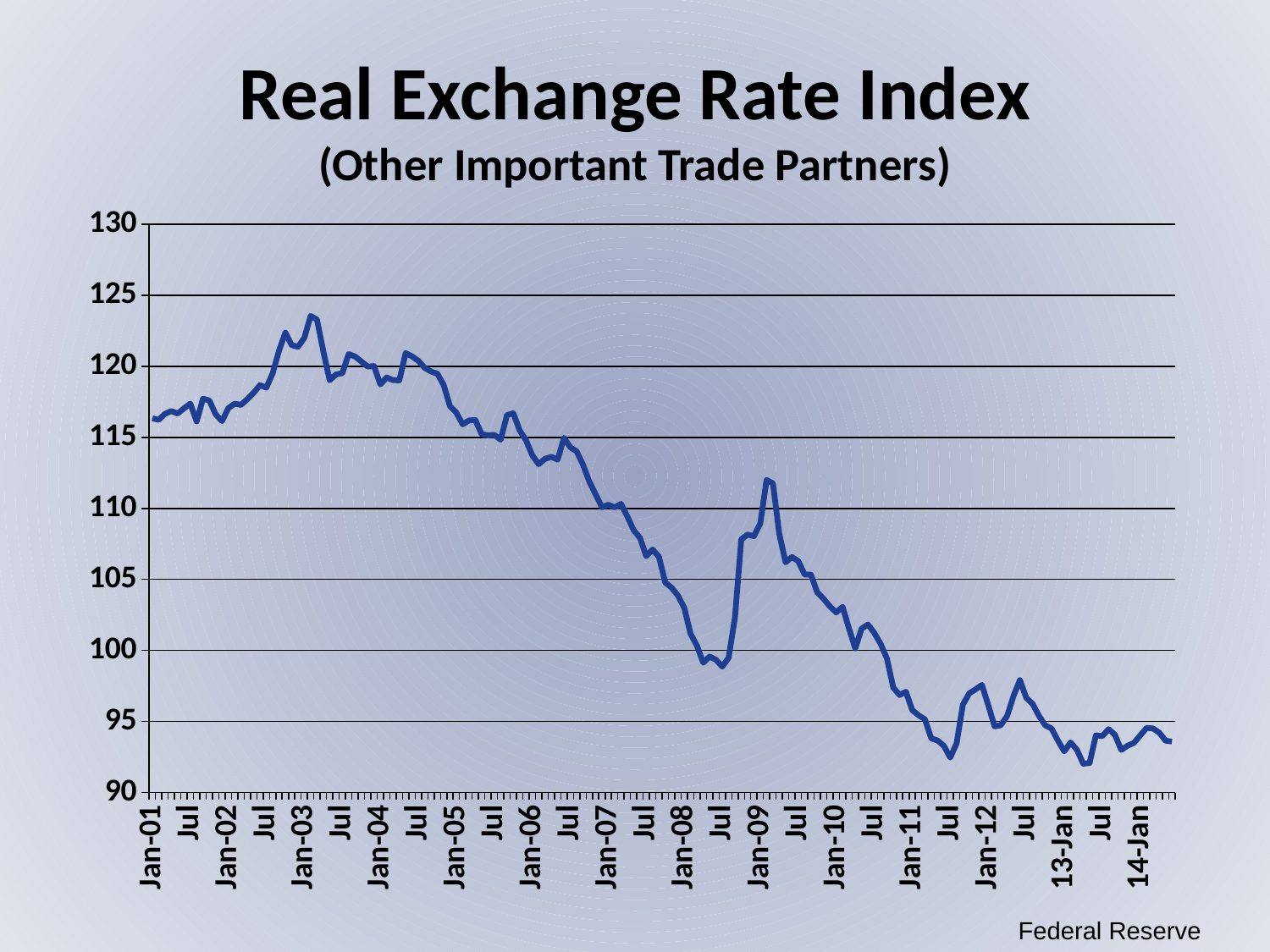
Is the value for Jan-03 greater or less than 120? greater What kind of chart is shown on the slide? line chart Does the index rise or fall between Jul-08 and Jan-09? rise Is the value for Jan-11 greater or less than 100? less Overall, does the Real Exchange Rate Index rise or fall from Jan-01 to 14-Jan? fall Is the value for Jan-01 greater or less than 110? greater What source is cited for the chart data? Federal Reserve Does the index rise or fall between Jan-08 and Jul-08? fall Which is larger, the value for Jan-01 or the value for Jan-12? Jan-01 In which year does the index reach its highest point? 2003 What is the title of the chart? Real Exchange Rate Index (Other Important Trade Partners)